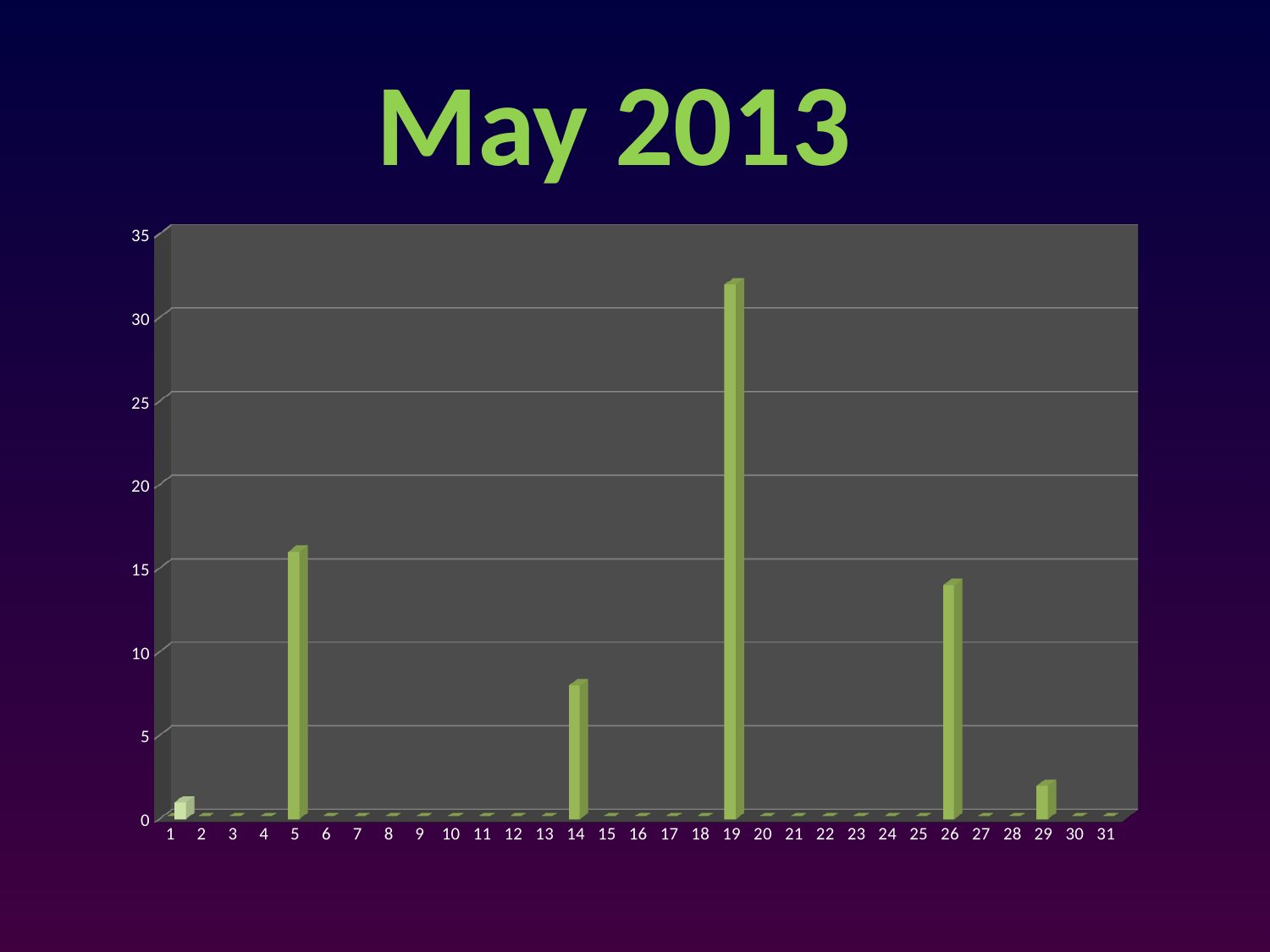
Which is larger, the value for category 19 or the value for category 5? 19 Is the value for category 19 greater or less than 30? greater What kind of chart is shown on the slide? bar chart Is the value for category 5 greater or less than 15? greater Is the value for category 1 greater or less than 5? less How many categories are shown along the x axis? 31 Which is larger, the value for category 14 or the value for category 26? 26 Which category has the highest bar? 19 What is the title of the chart? May 2013